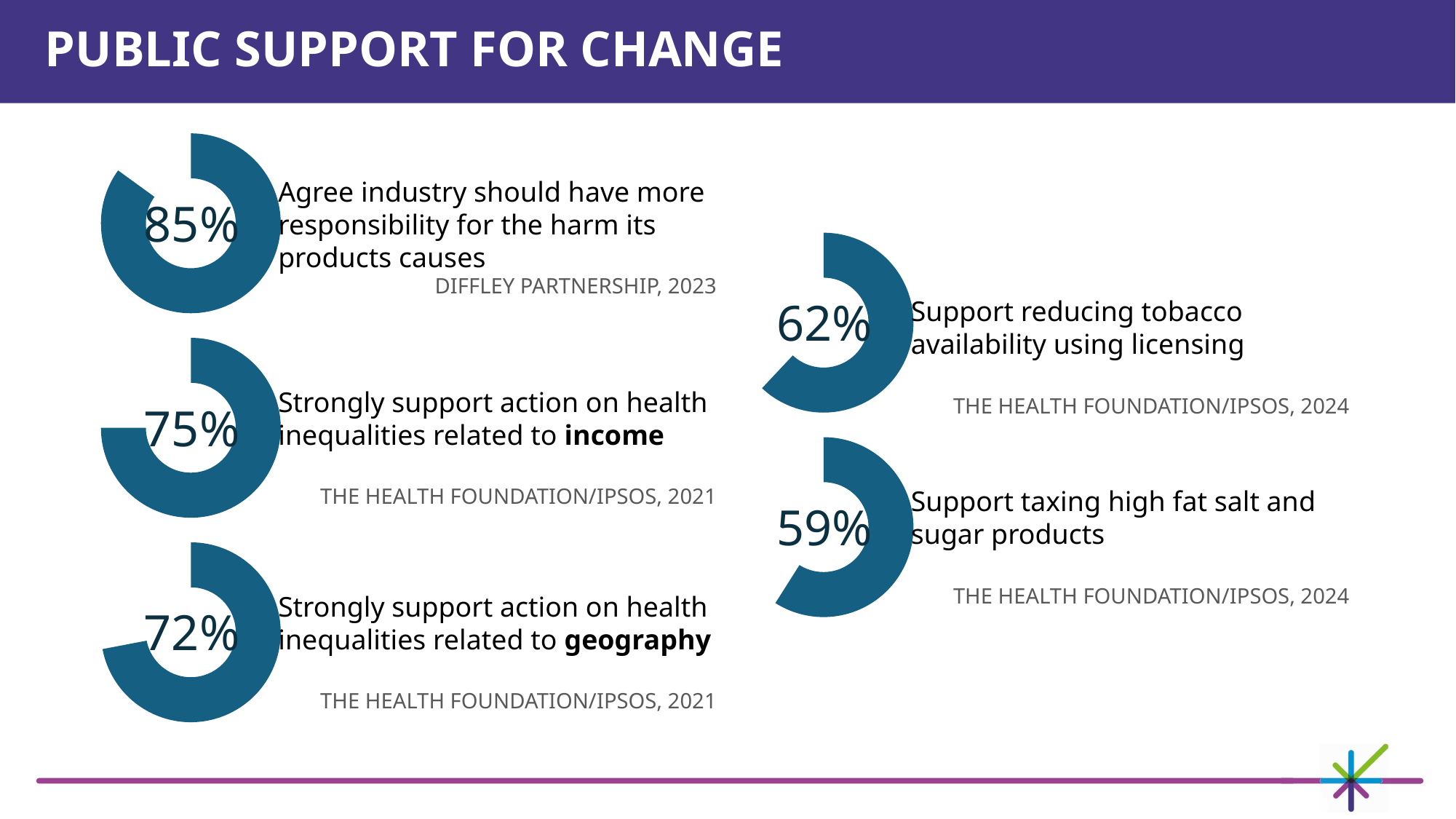
Which statement on the slide has the highest level of public support? Agree industry should have more responsibility for the harm its products causes Which statement on the slide has the lowest level of public support? Support taxing high fat salt and sugar products What percentage support taxing high fat salt and sugar products? 59% Which has more support: reducing tobacco availability using licensing, or taxing high fat salt and sugar products? Reducing tobacco availability using licensing What percentage of people agree industry should have more responsibility for the harm its products causes? 85% What percentage support reducing tobacco availability using licensing? 62% What kind of chart is used to show each percentage on the slide? Donut chart What is the title of the slide? PUBLIC SUPPORT FOR CHANGE What percentage strongly support action on health inequalities related to income? 75% How many donut charts are shown on the slide? 5 What percentage strongly support action on health inequalities related to geography? 72% What is the difference between the support for action on health inequalities related to income and related to geography? 3%